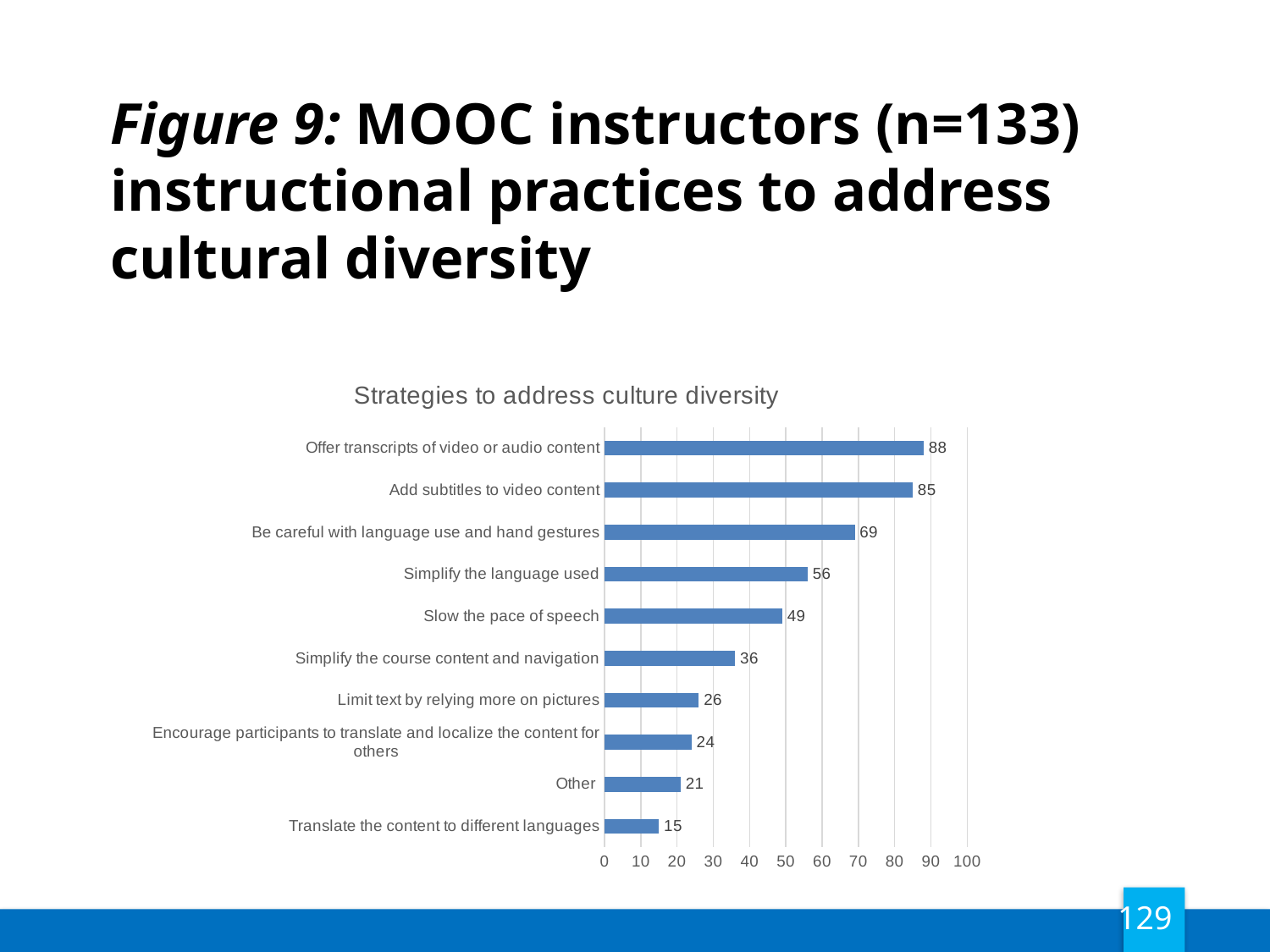
What is the value for "Slow the pace of speech"? 49 Which strategy has the highest value? Offer transcripts of video or audio content Is the value for "Be careful with language use and hand gestures" greater or less than 60? greater What is the value for "Offer transcripts of video or audio content"? 88 What is the maximum value shown on the horizontal axis? 100 What is the value for "Other"? 21 Which strategy has the lowest value? Translate the content to different languages Which is larger: "Limit text by relying more on pictures" or "Encourage participants to translate and localize the content for others"? Limit text by relying more on pictures How many strategies are shown in the chart? 10 What kind of chart is shown on the slide? Bar chart What is the difference between "Add subtitles to video content" and "Simplify the language used"? 29 What is the title of the chart? Strategies to address culture diversity